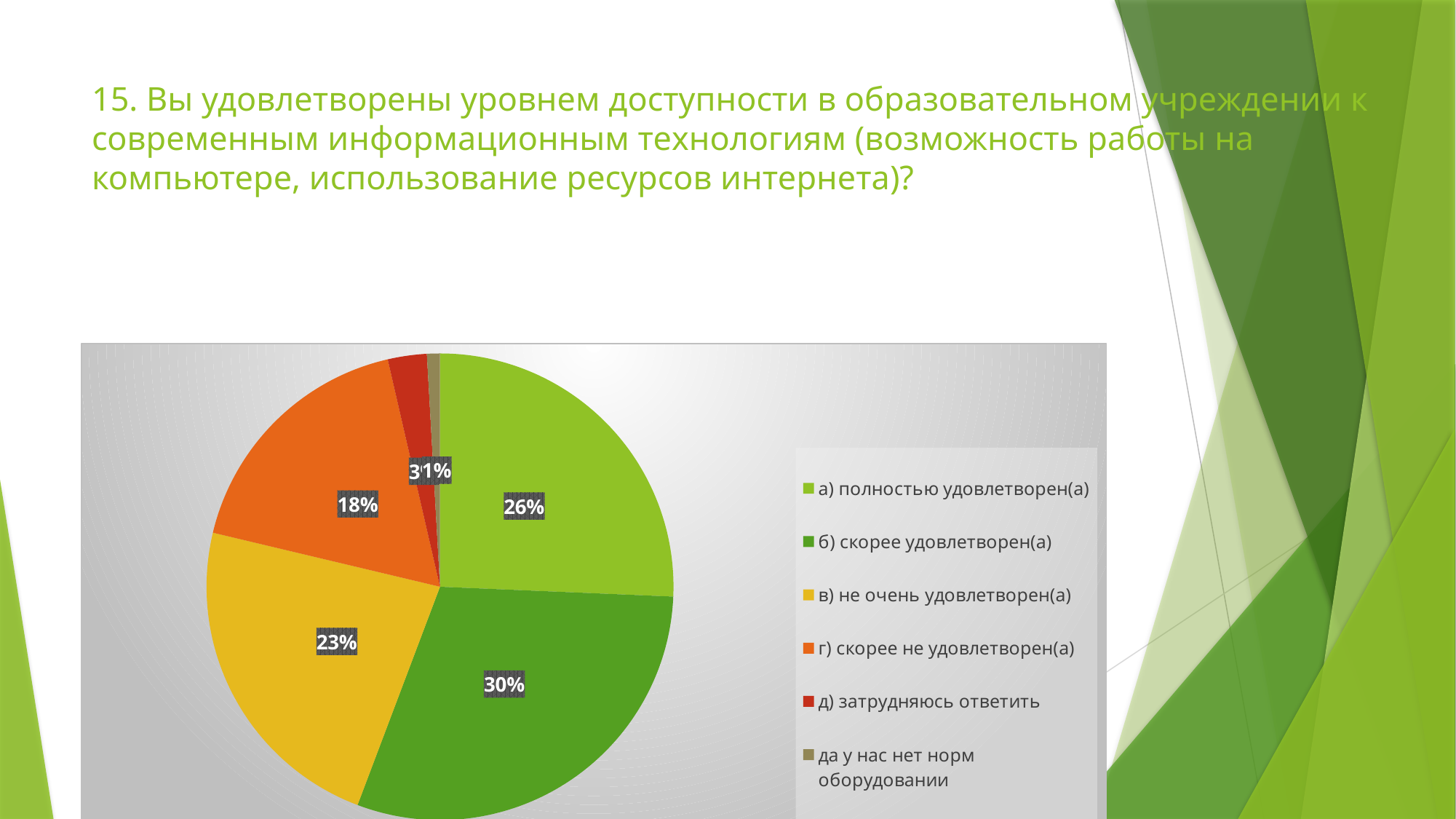
What is the difference between the shares for "в) не очень удовлетворен(а)" and "г) скорее не удовлетворен(а)"? 5% Which category has the smallest slice of the pie? да у нас нет норм оборудовании What percentage is shown for "б) скорее удовлетворен(а)"? 30% Which category has the largest slice of the pie? б) скорее удовлетворен(а) What is the difference between the shares for "б) скорее удовлетворен(а)" and "а) полностью удовлетворен(а)"? 4% What percentage is shown for "а) полностью удовлетворен(а)"? 26% What colour is the slice for "г) скорее не удовлетворен(а)"? orange How many categories does the legend list? 6 Which is larger: the share for "а) полностью удовлетворен(а)" or for "в) не очень удовлетворен(а)"? а) полностью удовлетворен(а) What percentage is shown for "в) не очень удовлетворен(а)"? 23% What percentage is shown for "г) скорее не удовлетворен(а)"? 18% What kind of chart is shown on the slide? pie chart